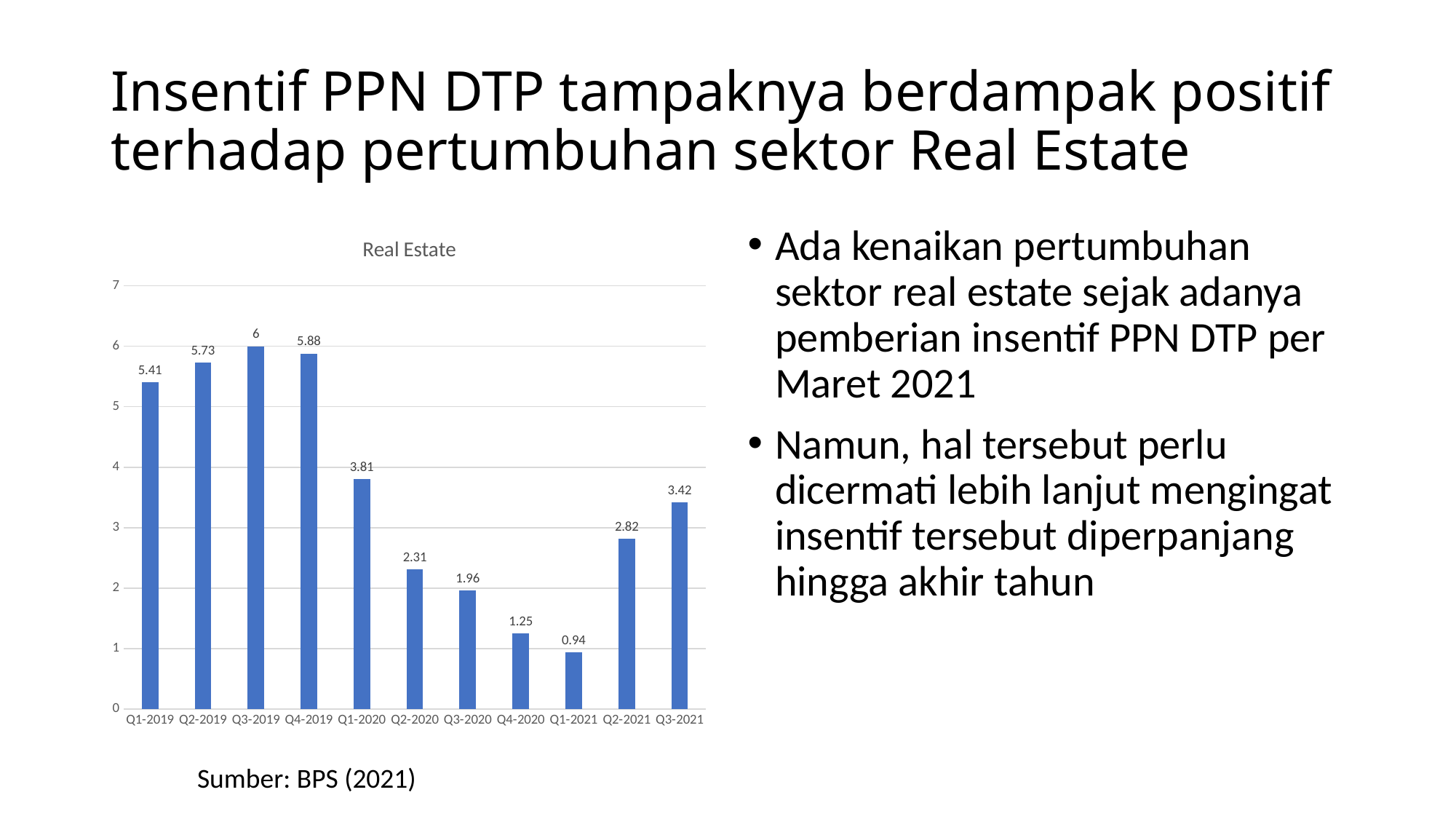
What is the difference between the values for Q2-2021 and Q1-2021? 1.88 How many quarters are shown on the x axis? 11 What is the value for Q1-2021? 0.94 Which quarter has the lowest value? Q1-2021 Which quarter has the highest value? Q3-2019 Do the values rise or fall from Q1-2021 to Q3-2021? Rise Which is larger, the value for Q2-2019 or the value for Q4-2019? Q4-2019 Is the value for Q2-2020 greater or less than 2? greater What is the title of the chart? Real Estate What is the value for Q1-2020? 3.81 What kind of chart is shown on the slide? Bar chart What is the value for Q3-2021? 3.42